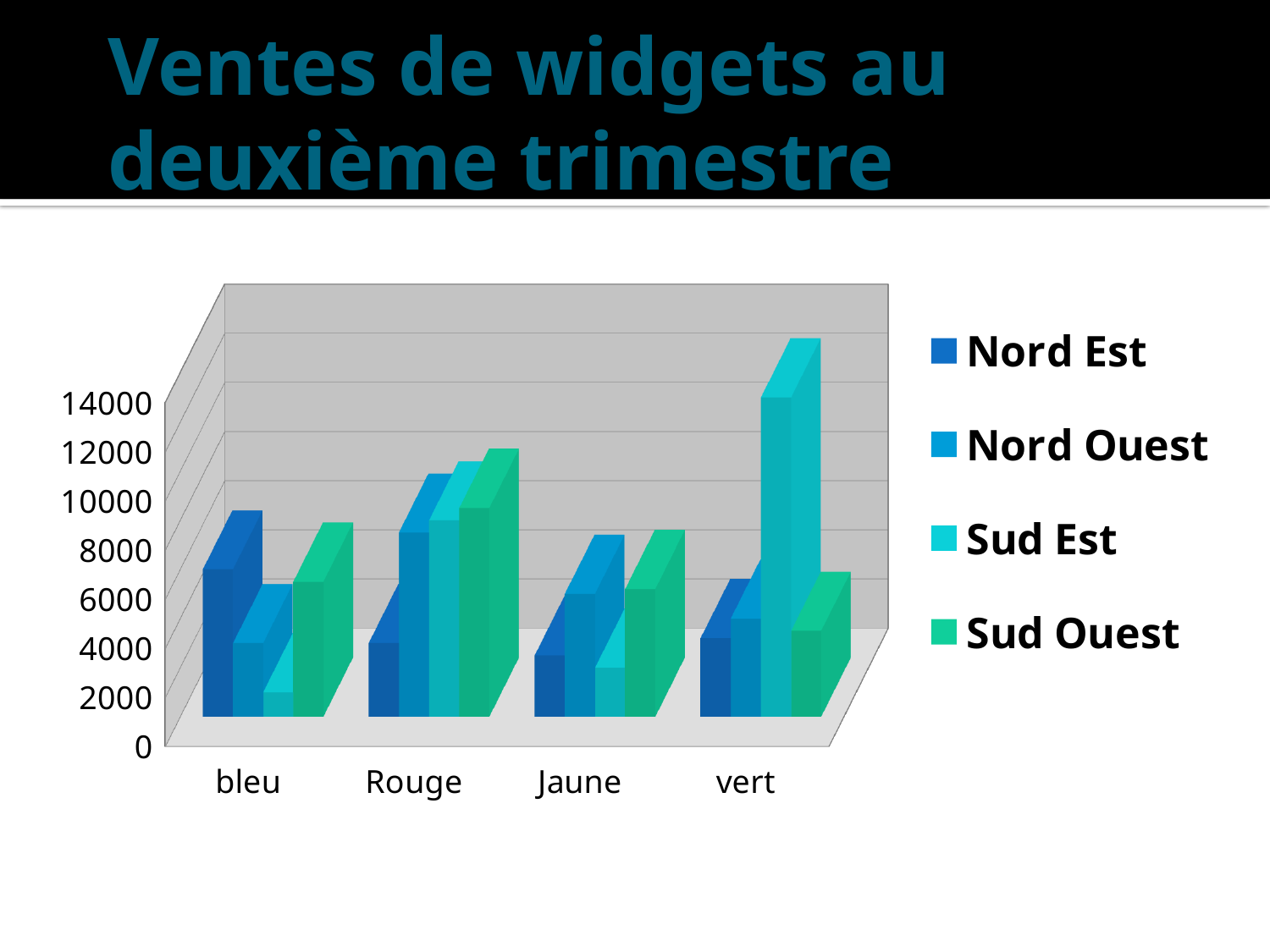
Which series has the highest value for the category vert? Sud Est How many series does the chart's legend list? 4 What is the title of the slide containing the chart? Ventes de widgets au deuxième trimestre Is the Sud Est value for bleu greater or less than 4000? less Which is larger: the Sud Est value for vert or the Sud Est value for Jaune? vert Which series has the lowest value for the category Rouge? Nord Est What kind of chart is shown on the slide? bar chart How many categories are shown on the x axis of the chart? 4 Which series has the lowest value for the category bleu? Sud Est Is the Sud Est value for vert greater or less than 10000? greater Which is larger: the Nord Est value for bleu or the Nord Est value for Jaune? bleu